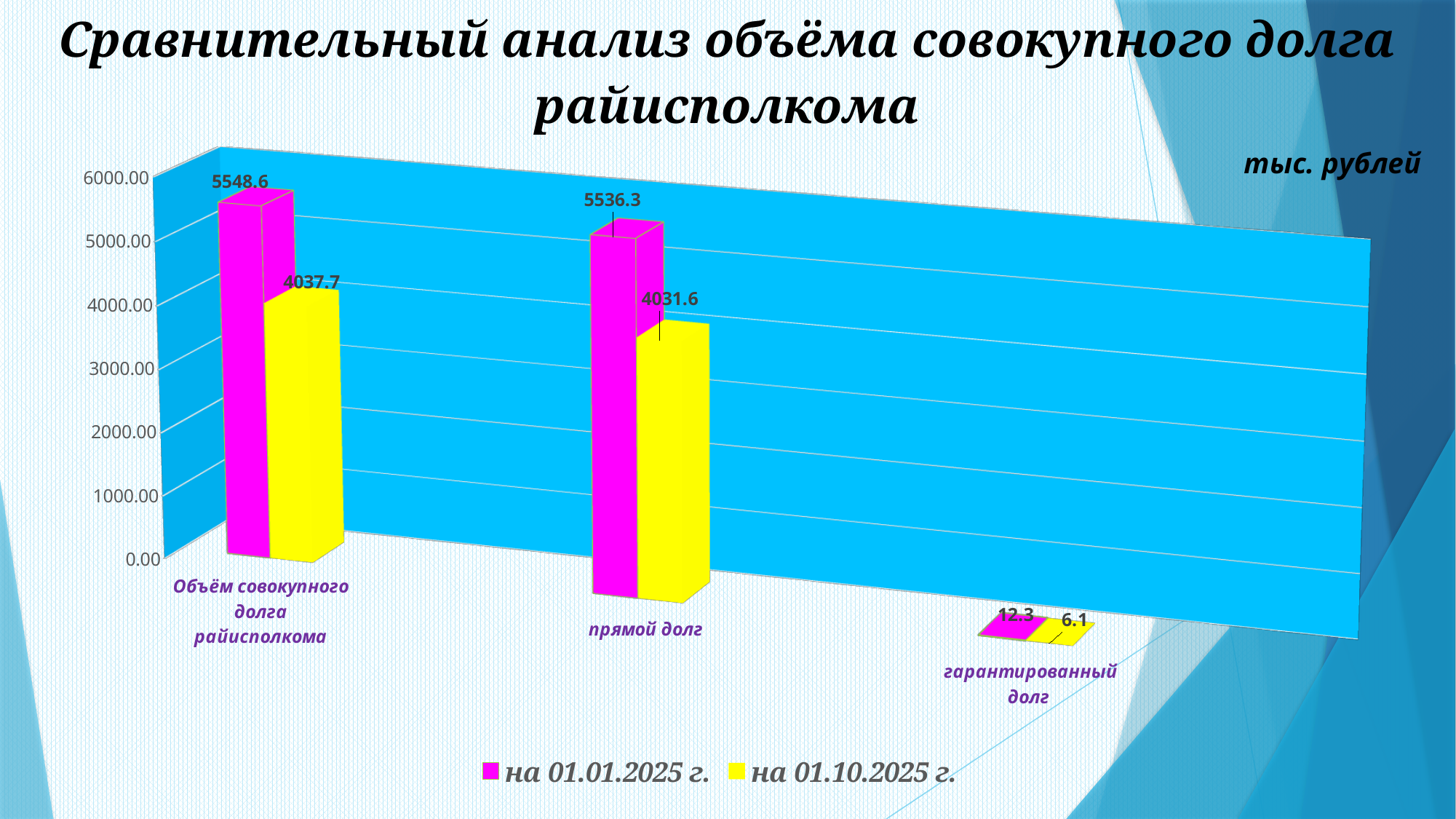
How many series does the legend list? 2 What type of chart is shown on the slide? Bar chart Which category has the highest value in the series «на 01.01.2025 г.»? Объём совокупного долга райисполкома How many categories are shown on the x axis of the chart? 3 What is the difference between the «на 01.01.2025 г.» and «на 01.10.2025 г.» values for «Объём совокупного долга райисполкома»? 1510.9 What is the value for «гарантированный долг» in the series «на 01.01.2025 г.»? 12.3 For «прямой долг», which series has the larger value: «на 01.01.2025 г.» or «на 01.10.2025 г.»? на 01.01.2025 г. What is the value for «Объём совокупного долга райисполкома» in the series «на 01.01.2025 г.»? 5548.6 What is the value for «прямой долг» in the series «на 01.10.2025 г.»? 4031.6 What is the difference between the «на 01.01.2025 г.» and «на 01.10.2025 г.» values for «прямой долг»? 1504.7 Which category has the lowest value in the series «на 01.10.2025 г.»? гарантированный долг What is the value for «гарантированный долг» in the series «на 01.10.2025 г.»? 6.1